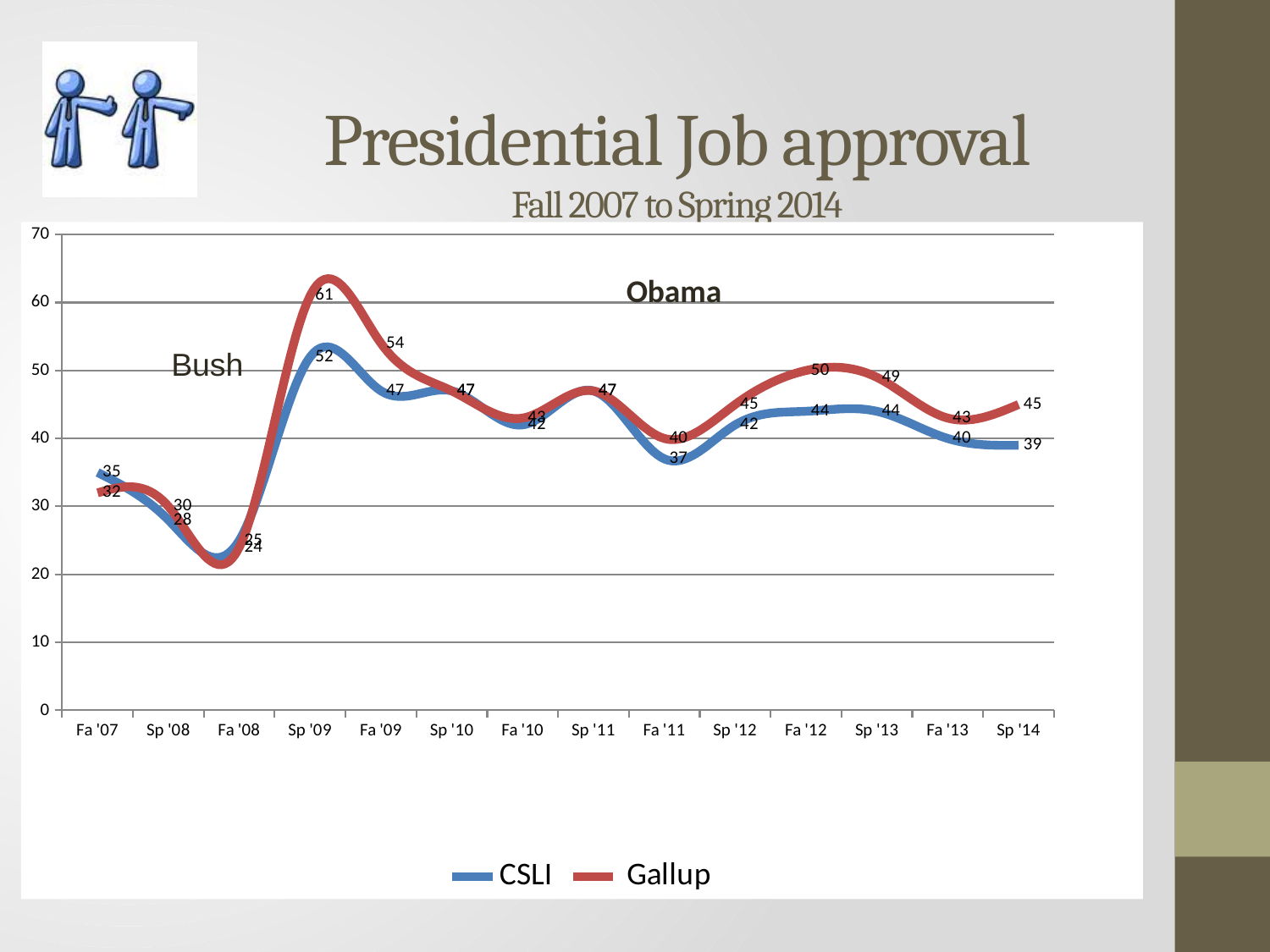
At which period is the CSLI series at its lowest value? Fa '08 At which period does the Gallup series reach its highest value? Sp '09 At Fa '07, which series has the higher value, CSLI or Gallup? CSLI How many series does the legend list? 2 What is the Gallup approval value for Sp '09? 61 What is the Gallup value for Fa '12? 50 Is the Gallup value for Sp '09 greater or less than 60? greater How many time periods are shown on the x axis? 14 What is the difference between the Gallup and CSLI values at Sp '09? 9 Do the approval values rise or fall from Fa '07 to Fa '08? Fall What kind of chart is shown on the slide? Line chart What is the CSLI approval value for Sp '14? 39